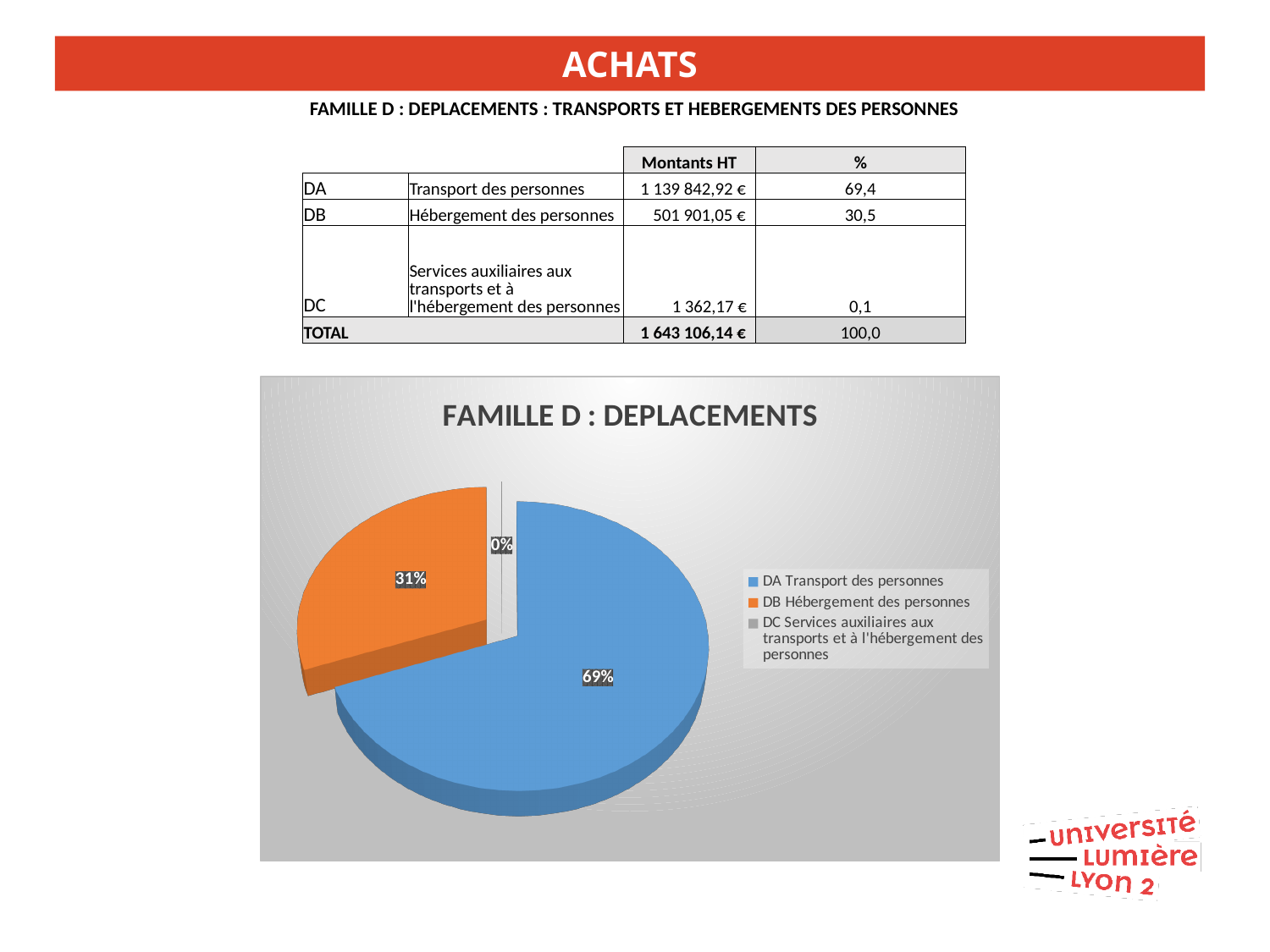
What kind of chart is shown on the slide? pie chart What is the difference in percentage points between the DA Transport des personnes slice and the DB Hébergement des personnes slice? 38 What share of the pie does DB Hébergement des personnes represent? 31% Which category has the smallest slice of the pie? DC Services auxiliaires aux transports et à l'hébergement des personnes What share of the pie does DA Transport des personnes represent? 69% What colour is the slice for DB Hébergement des personnes? orange Which is larger, the slice for DA Transport des personnes or the slice for DB Hébergement des personnes? DA Transport des personnes Which category has the largest slice of the pie? DA Transport des personnes How many entries does the legend list? 3 What share of the pie does DC Services auxiliaires aux transports et à l'hébergement des personnes represent? 0% How many categories does the pie chart show? 3 What is the title of the chart? FAMILLE D : DEPLACEMENTS